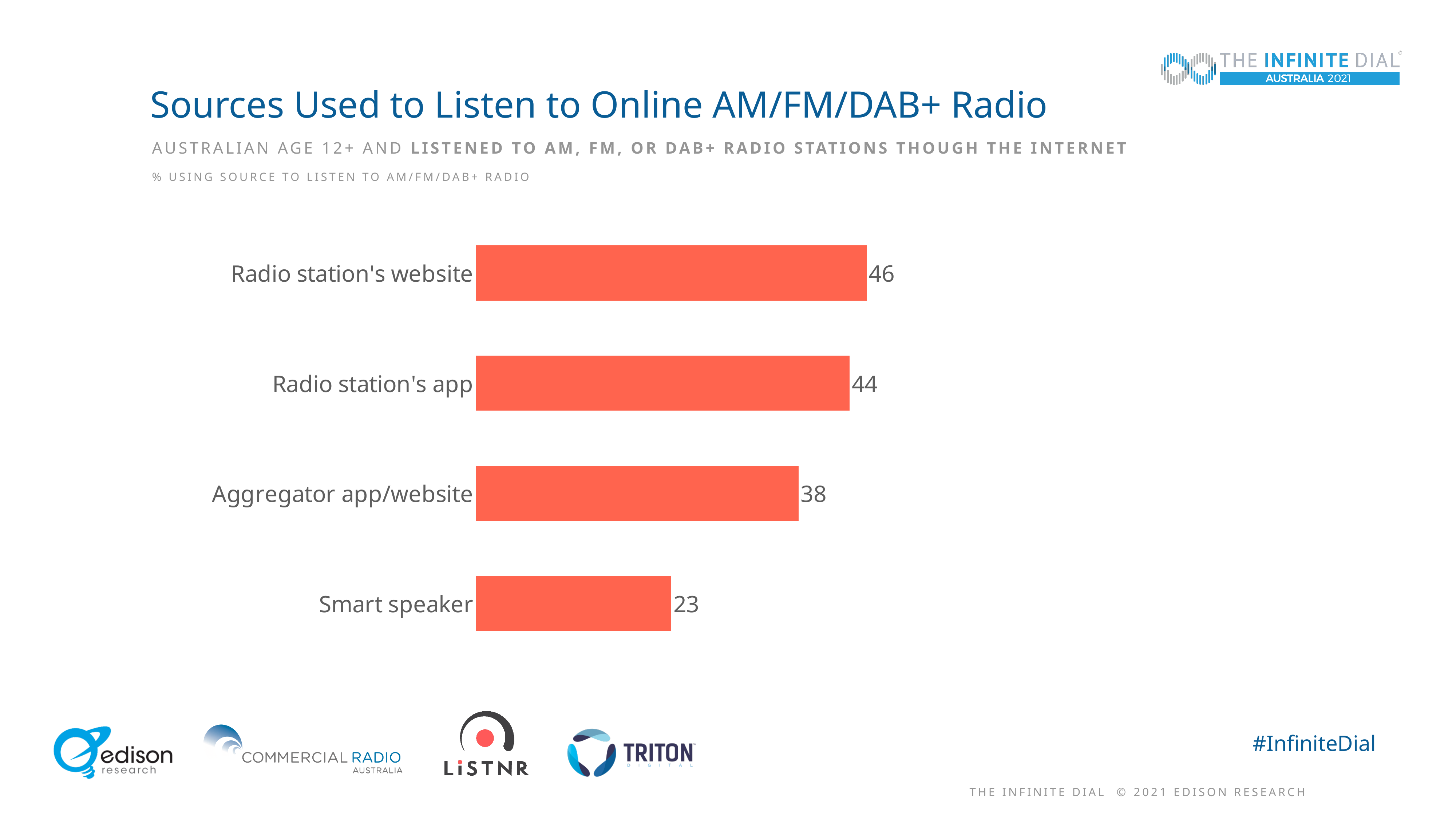
How many sources are shown in the chart? 4 What is the difference between the values for Radio station's app and Aggregator app/website? 6 What kind of chart is shown on the slide? Bar chart What is the difference between the values for Radio station's website and Smart speaker? 23 What is the value for Radio station's website? 46 Which source has the highest value? Radio station's website What is the value for Aggregator app/website? 38 Which is larger, the value for Aggregator app/website or the value for Smart speaker? Aggregator app/website What is the title of the chart on the slide? Sources Used to Listen to Online AM/FM/DAB+ Radio What is the value for Smart speaker? 23 What is the value for Radio station's app? 44 Which source has the lowest value? Smart speaker